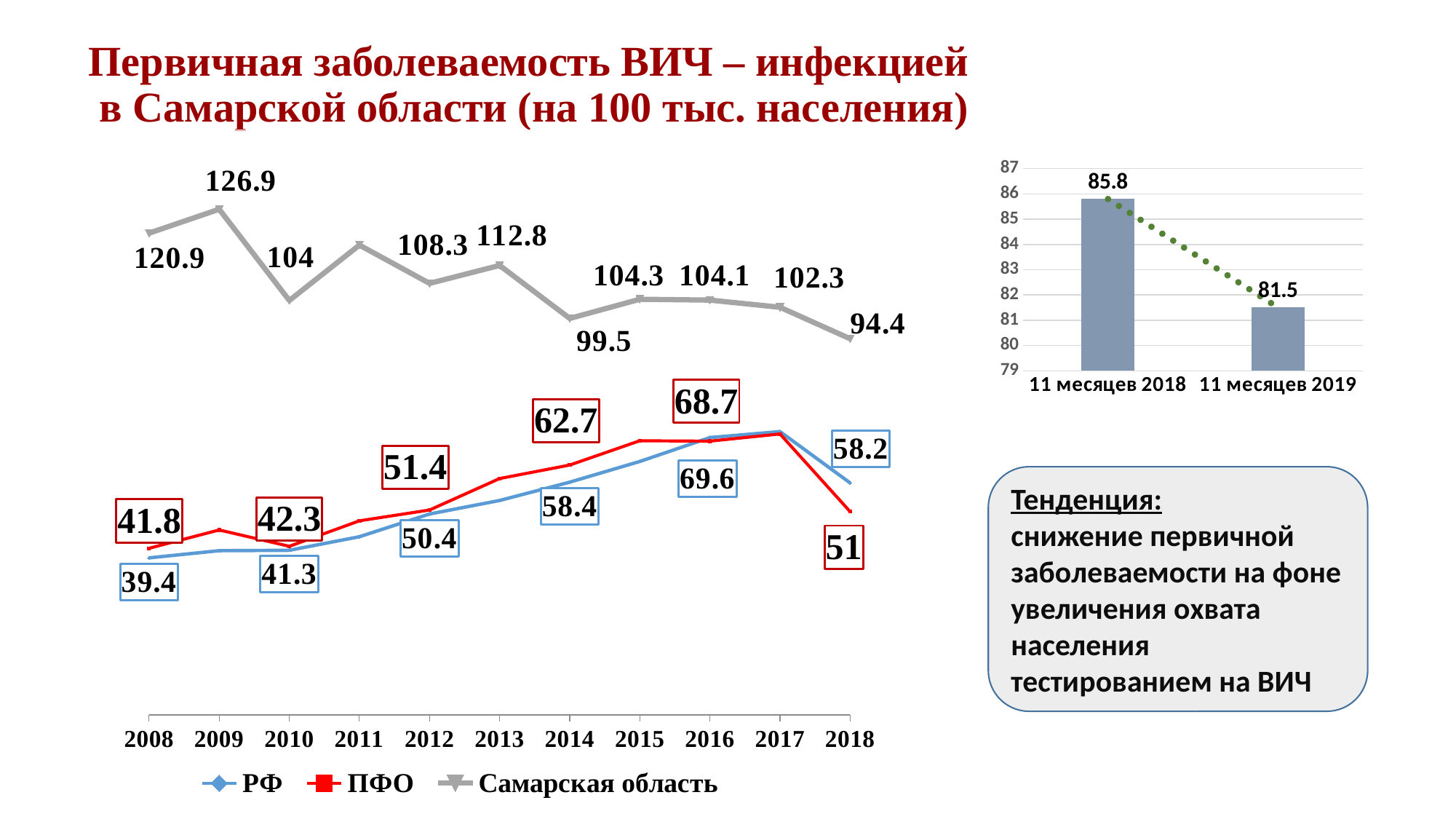
How many series does the legend of the line chart list? 3 What kind of chart is the small chart on the right of the slide? bar chart In the line chart, what is the value for ПФО in 2018? 51 How many years are shown on the x axis of the line chart? 11 In the line chart, in which year is the value for Самарская область lowest? 2018 In the bar chart on the right, what is the difference between the values for 11 месяцев 2018 and 11 месяцев 2019? 4.3 In the line chart, what is the value for Самарская область in 2009? 126.9 In the line chart, which is larger in 2014: the value for РФ or for ПФО? ПФО In the line chart, in which year is the value for Самарская область highest? 2009 In the line chart, does the value for Самарская область rise or fall from 2015 to 2018? fall In the line chart, what is the value for РФ in 2016? 69.6 In the line chart, what is the difference between the Самарская область values in 2008 and 2018? 26.5